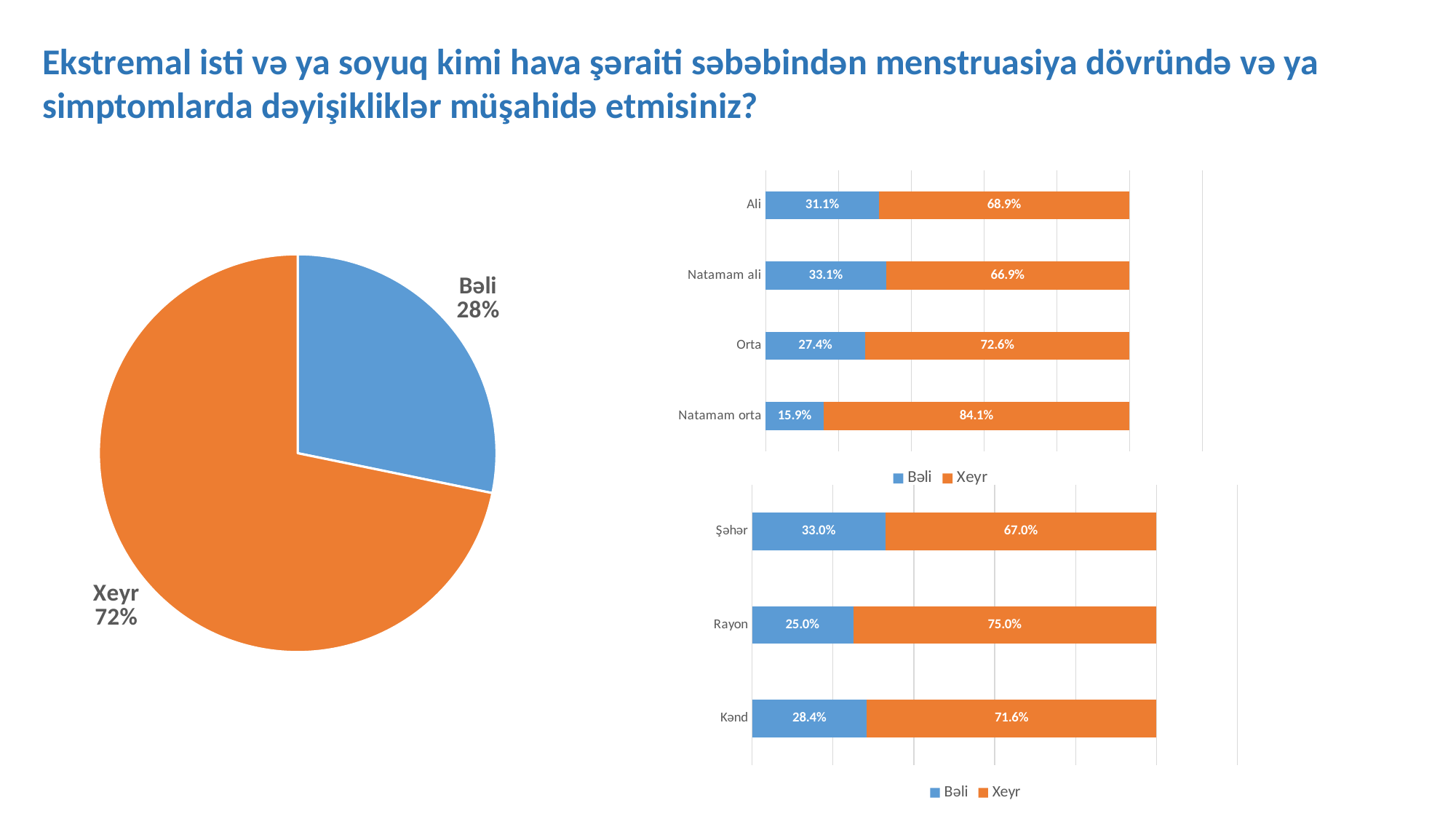
What kind of chart is the chart on the left of the slide? pie chart In the top-right bar chart, what is the difference between the Xeyr values for Natamam orta and Ali? 15.2% In the bottom-right bar chart, which category has the highest Xeyr value? Rayon In the pie chart on the left, what share of respondents answered Bəli? 28% In the top-right bar chart, what is the Xeyr value for Orta? 72.6% In the top-right bar chart, what is the Bəli value for Natamam orta? 15.9% How many series does the legend of the bottom-right bar chart list? 2 In the bottom-right bar chart, is the Bəli value for Şəhər larger or smaller than the Bəli value for Kənd? larger In the bottom-right bar chart, what is the Bəli value for Rayon? 25.0% In the pie chart on the left, what share of respondents answered Xeyr? 72% In the top-right bar chart, which category has the highest Bəli value? Natamam ali In the top-right bar chart, which category has the lowest Bəli value? Natamam orta